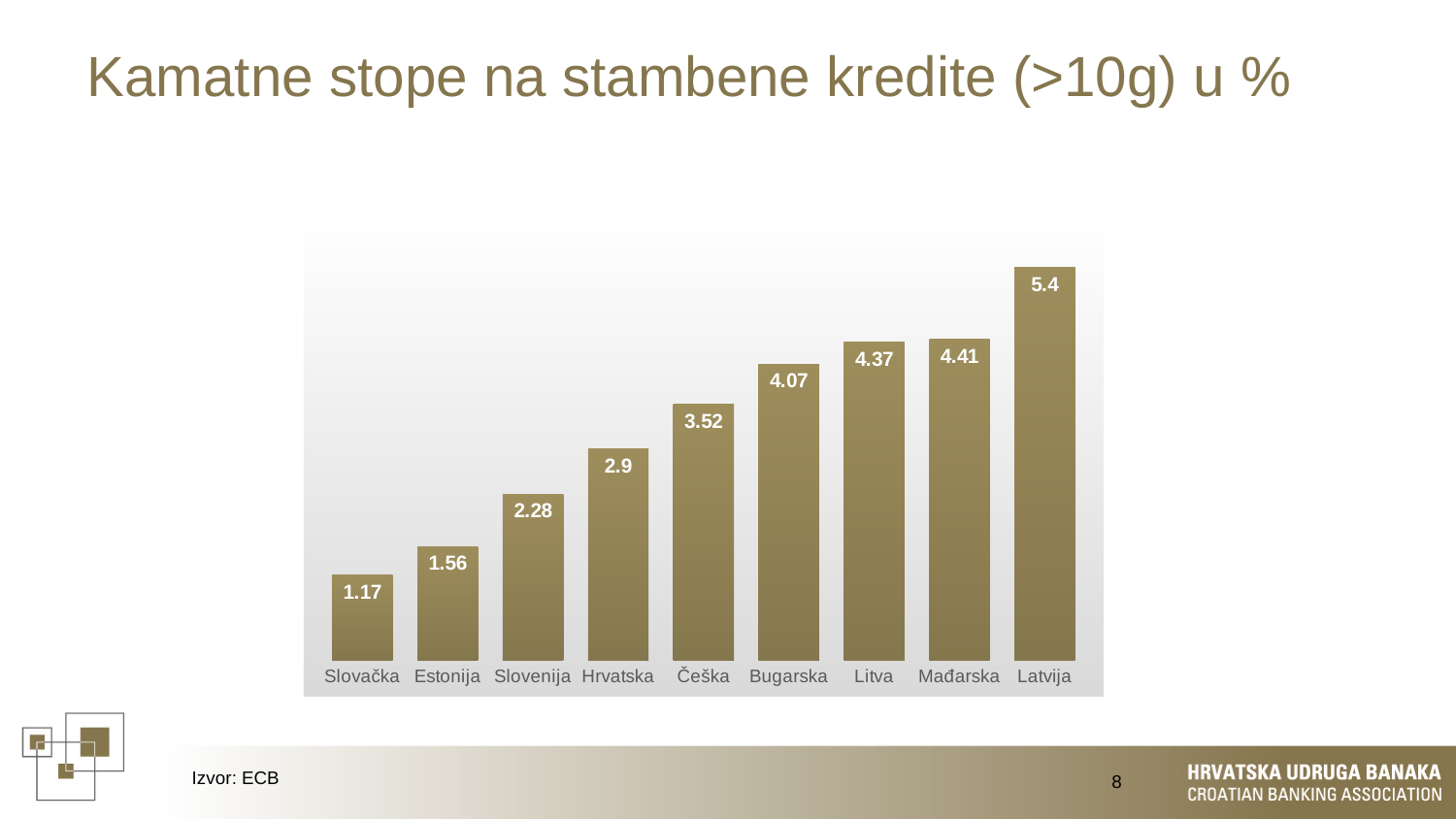
What is the difference between the values for Latvija and Slovačka? 4.23 What is the difference between the values for Češka and Hrvatska? 0.62 What is the value for Slovenija? 2.28 Which country has the highest value? Latvija How many countries are shown in the chart? 9 Do the values rise or fall from left to right across the chart? rise Which country has the lowest value? Slovačka What is the value for Bugarska? 4.07 What is the value for Hrvatska? 2.9 What is the title of the slide? Kamatne stope na stambene kredite (>10g) u % Which is larger, the value for Estonija or the value for Slovenija? Slovenija What kind of chart is shown on the slide? bar chart